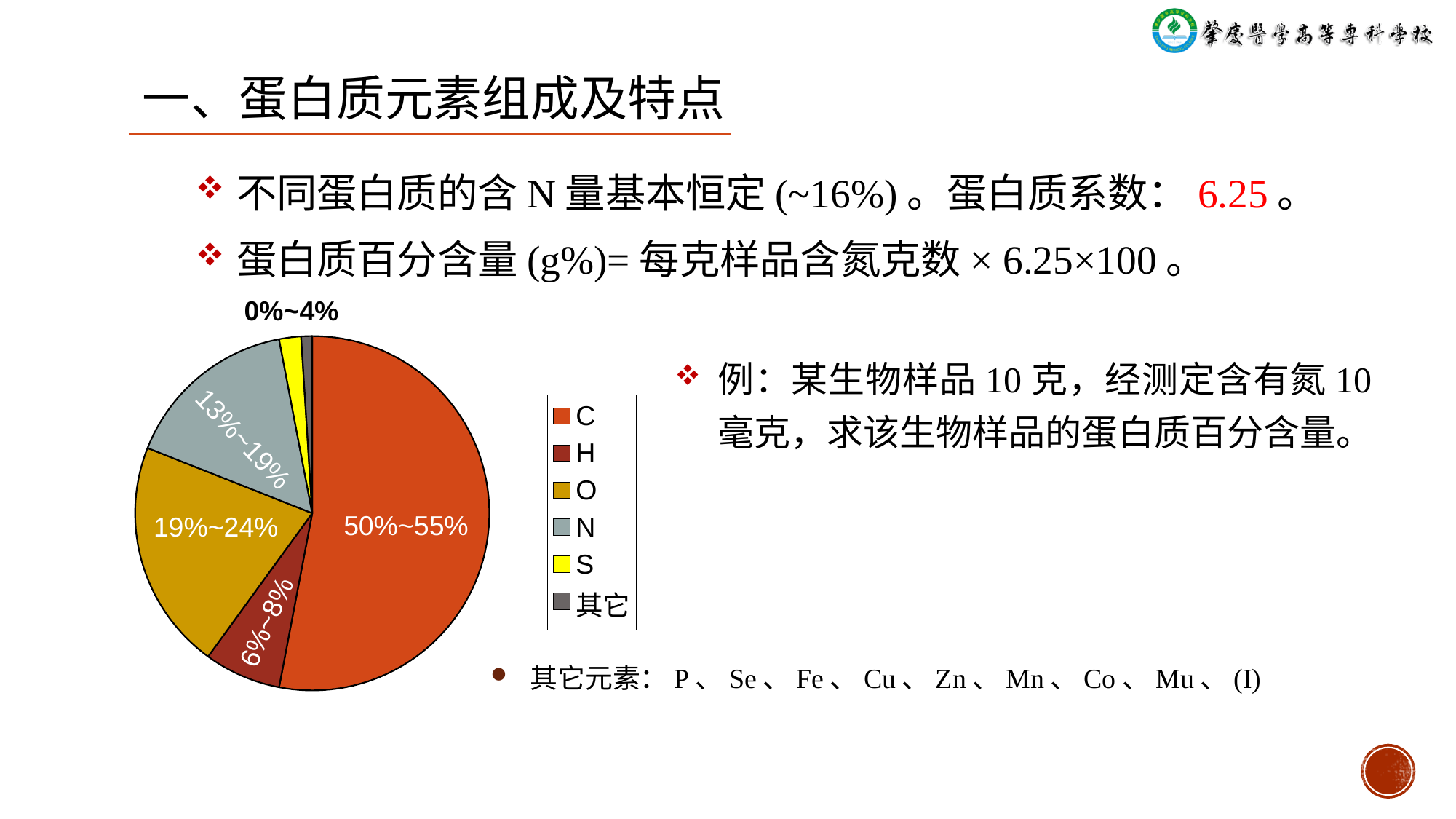
Which slice is larger in the pie chart, C or N? C How many slices does the pie chart have? 6 Which slice is larger in the pie chart, O or H? O Which element has the largest slice in the pie chart? C What range is labelled on the O slice of the pie chart? 19%~24% What range is labelled on the N slice of the pie chart? 13%~19% How many entries does the legend of the pie chart list? 6 What range is labelled on the C slice of the pie chart? 50%~55% What kind of chart is shown on the slide? pie chart Which legend entry in the pie chart is shown in grey? 其它 What colour is the S slice in the pie chart? yellow What range is labelled on the H slice of the pie chart? 6%~8%